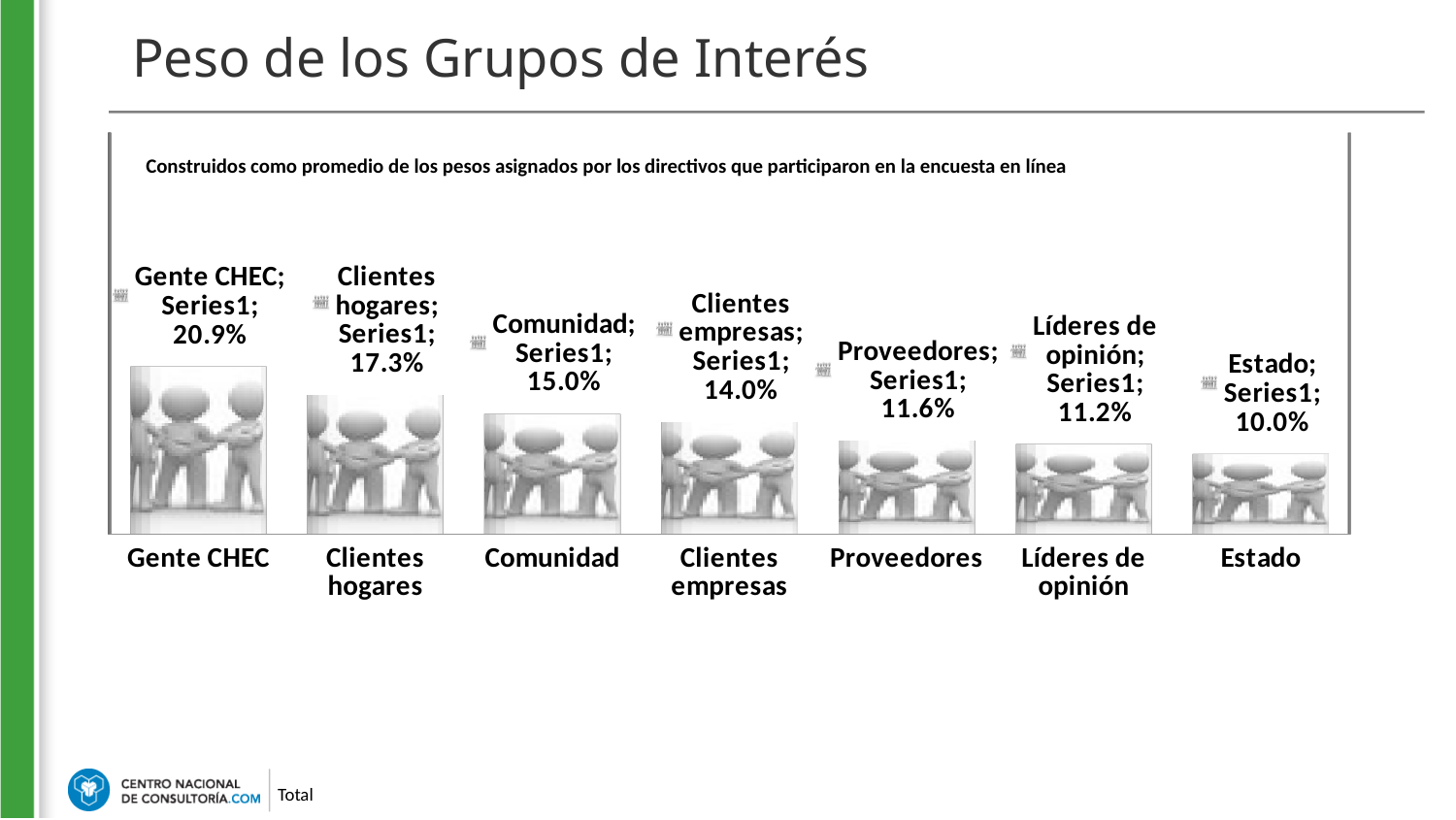
Which is larger, the value for Clientes hogares or the value for Comunidad? Clientes hogares What is the difference between the values for Comunidad and Clientes empresas? 1.0% What is the value for Estado? 10.0% Do the values rise or fall from left to right across the categories? Fall What kind of chart is shown on the slide? Bar chart Which category has the lowest value? Estado What is the value for Proveedores? 11.6% Which category has the highest value? Gente CHEC What is the difference between the values for Gente CHEC and Estado? 10.9% What is the value for Gente CHEC? 20.9% What is the value for Clientes hogares? 17.3% How many categories are shown in the chart? 7